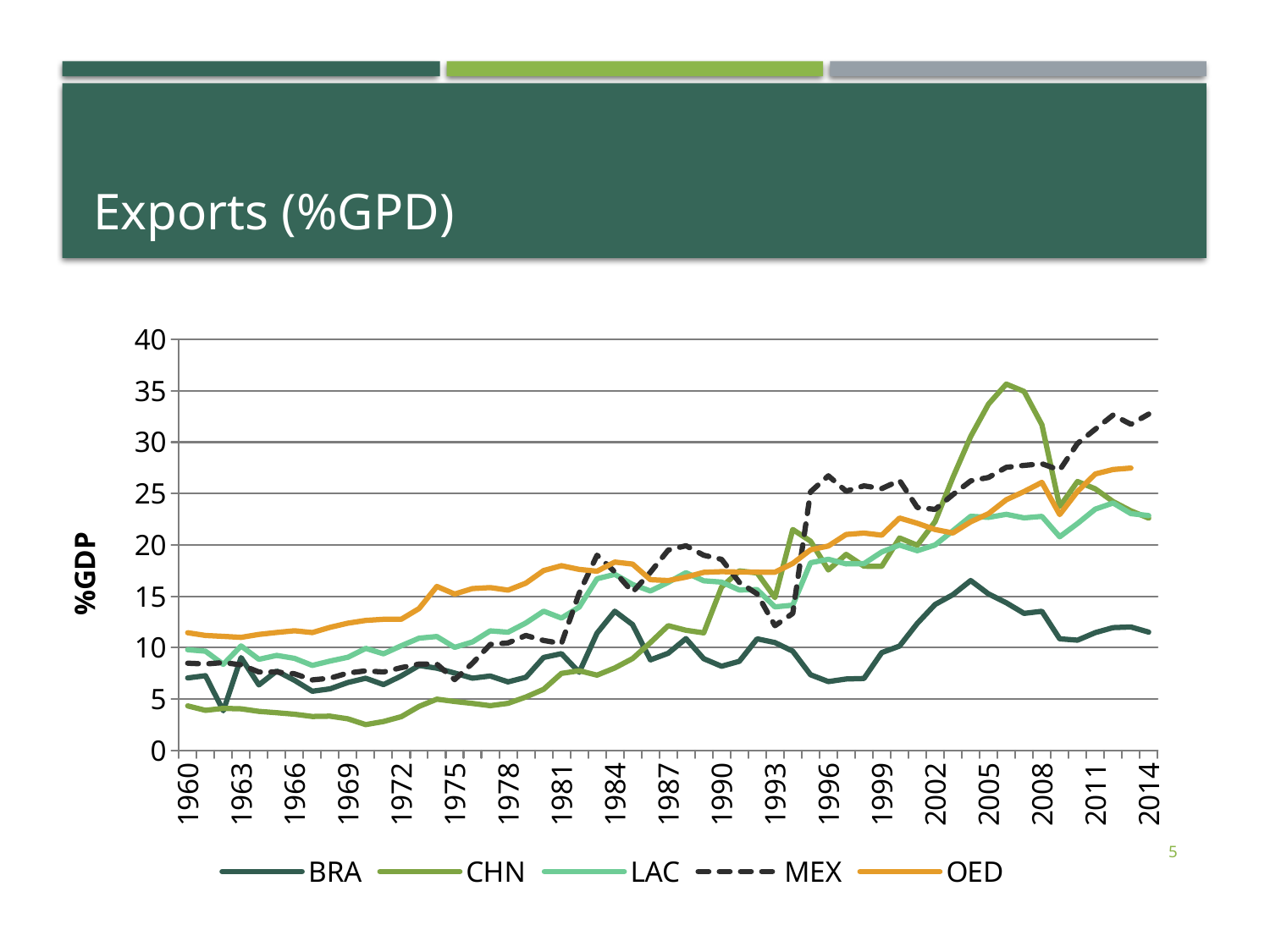
Which series is drawn as a dashed line? MEX Is the value for OED in 1960 greater or less than 10? greater What is the title of the slide containing the chart? Exports (%GPD) What kind of chart is shown on the slide? line chart Which series has the highest value in 2014? MEX Is the value for CHN in 1970 greater or less than 5? less Which series has the lowest value in 2014? BRA Does the OED series generally rise or fall from 1960 to 2014? rise How many series does the legend list? 5 In 2014, which is larger, the value for MEX or the value for BRA? MEX Is the value for BRA in 2014 greater or less than 15? less